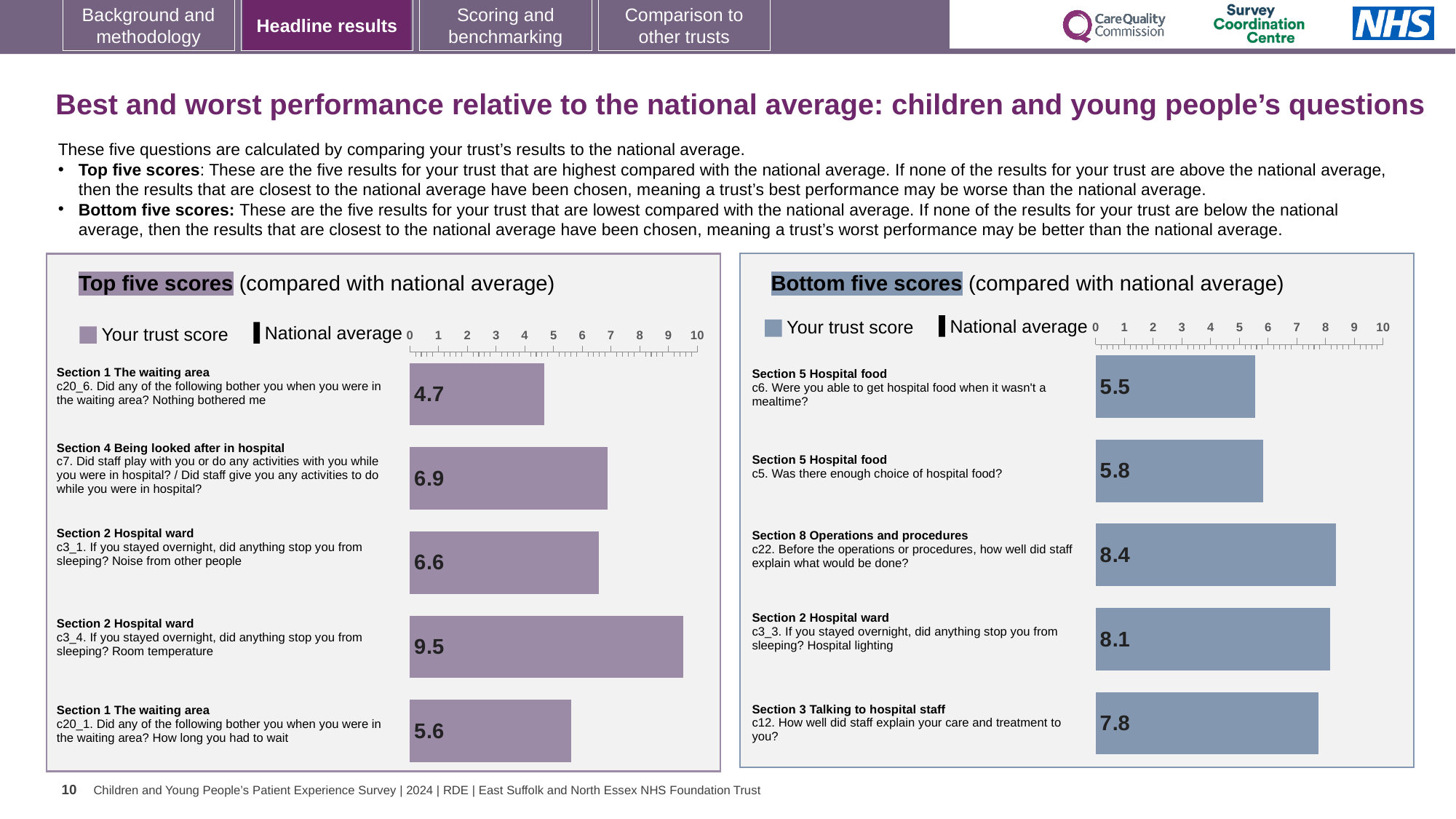
In the Top five scores chart, what is the difference between the trust scores for c7 (staff play with you or do activities) and c3_1 (noise from other people)? 0.3 How many series does the legend of the Top five scores chart list? 2 In the Bottom five scores chart, which has the larger trust score: c3_3 (hospital lighting) or c12 (how well did staff explain your care and treatment)? c3_3 (hospital lighting) In the Top five scores chart, which question has the highest trust score? c3_4. If you stayed overnight, did anything stop you from sleeping? Room temperature In the Top five scores chart, what is the trust score for c3_4 (anything stop you from sleeping? Room temperature)? 9.5 How many bars are plotted in the Bottom five scores chart? 5 In the Bottom five scores chart, which question has the lowest trust score? c6. Were you able to get hospital food when it wasn't a mealtime? In the Top five scores chart, what is the trust score for c20_6 (Nothing bothered me in the waiting area)? 4.7 In the Bottom five scores chart, what is the trust score for c22 (how well did staff explain what would be done before operations or procedures)? 8.4 In the Bottom five scores chart, what is the trust score for c6 (able to get hospital food when it wasn't a mealtime)? 5.5 What type of chart is used in the Top five scores panel? Bar chart In the Bottom five scores chart, what is the difference between the trust scores for c22 (8.4) and c5 (enough choice of hospital food)? 2.6